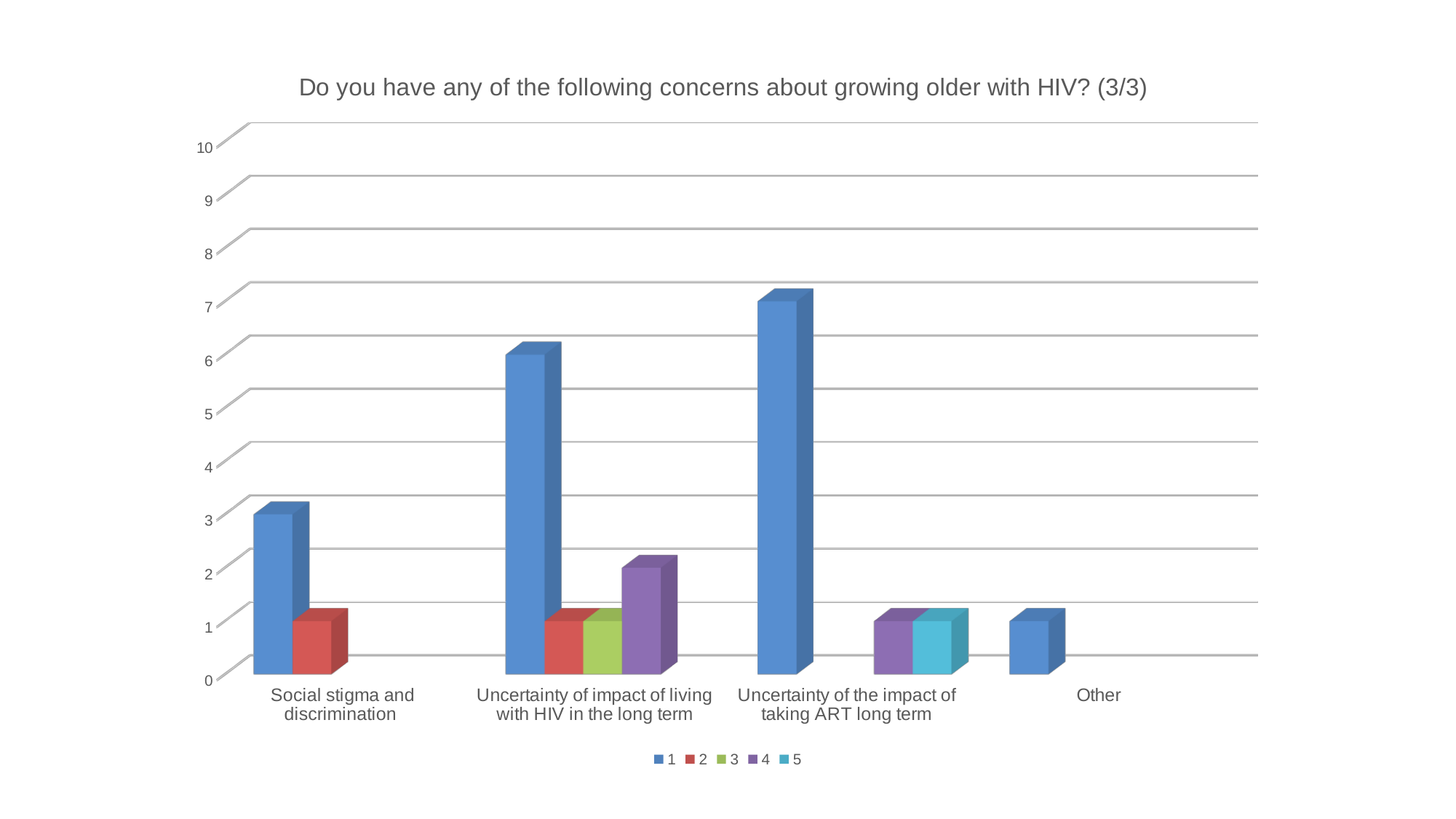
Is the series 1 value for Uncertainty of impact of living with HIV in the long term greater or less than 4? greater What is the title of the chart? Do you have any of the following concerns about growing older with HIV? (3/3) Is the series 1 value for Uncertainty of the impact of taking ART long term greater or less than 5? greater Is the series 1 value for Social stigma and discrimination greater or less than 5? less How many series does the legend list? 5 Which category has the tallest bar for series 1? Uncertainty of the impact of taking ART long term For series 1, which is larger: Social stigma and discrimination or Uncertainty of impact of living with HIV in the long term? Uncertainty of impact of living with HIV in the long term Which category has the shortest bar for series 1? Other How many categories are shown on the x axis? 4 What type of chart is shown on the slide? bar chart What is the series 1 value for Uncertainty of the impact of taking ART long term? 7 What colour represents series 1 in the legend? blue